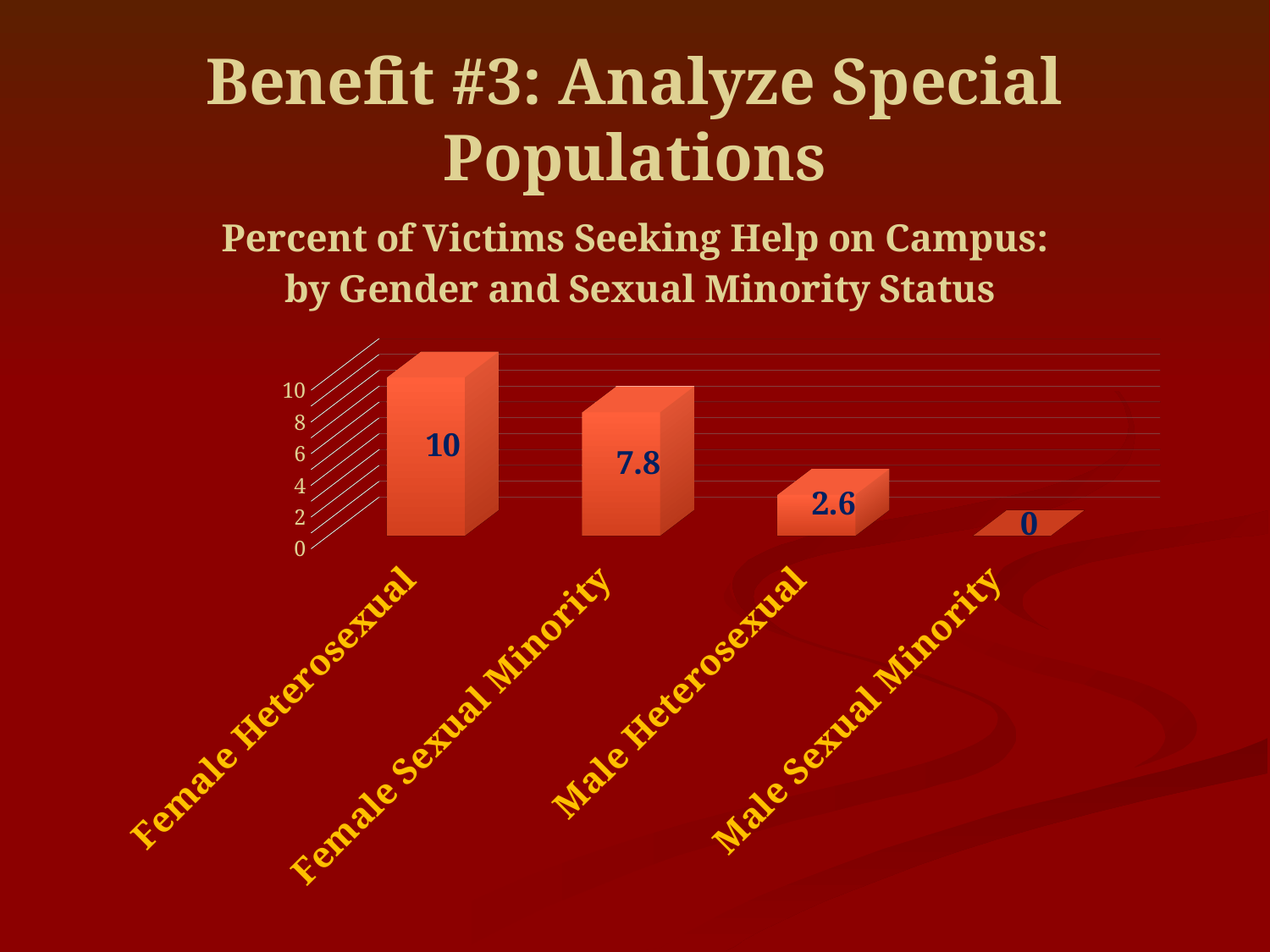
What is the value for Male Heterosexual? 2.6 What is the difference between the values for Female Sexual Minority and Male Heterosexual? 5.2 What is the title of the chart? Percent of Victims Seeking Help on Campus: by Gender and Sexual Minority Status What is the value for Female Sexual Minority? 7.8 What is the value for Female Heterosexual? 10 Which category has the lowest value? Male Sexual Minority How many categories are shown on the chart? 4 What kind of chart is shown on the slide? Bar chart What is the difference between the values for Female Heterosexual and Female Sexual Minority? 2.2 Which is larger, the value for Female Sexual Minority or the value for Male Heterosexual? Female Sexual Minority What is the value for Male Sexual Minority? 0 Which category has the highest value? Female Heterosexual